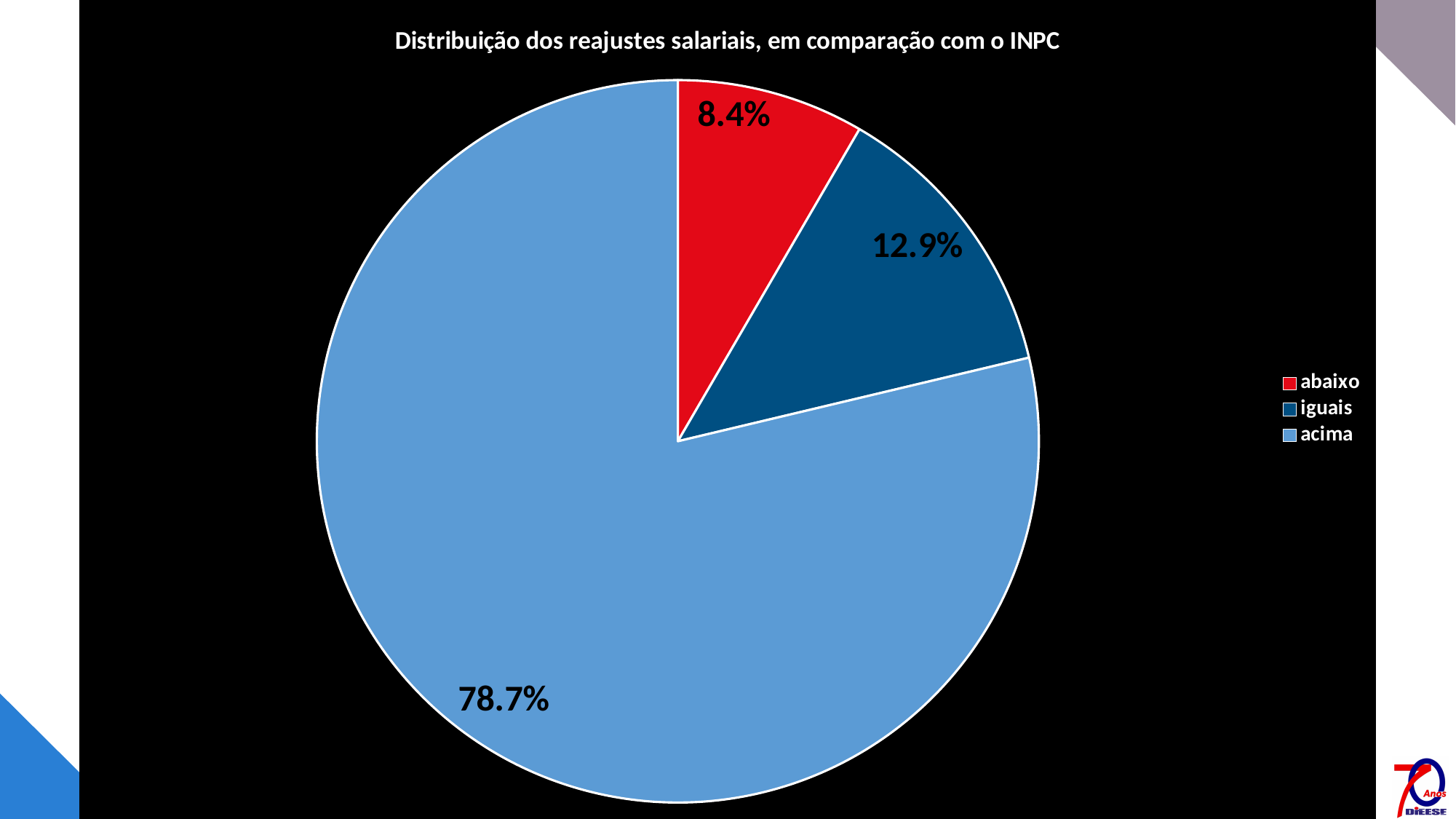
What is the difference between the 'iguais' and 'abaixo' shares? 4.5% What kind of chart is shown on the slide? pie chart Which is larger, the 'iguais' slice or the 'abaixo' slice? iguais What is the difference between the 'acima' and 'iguais' shares? 65.8% What colour is the 'abaixo' slice? red What is the title of the chart? Distribuição dos reajustes salariais, em comparação com o INPC How many slices does the pie chart have? 3 Which category has the smallest share of the pie? abaixo Which category has the largest share of the pie? acima What is the value for the 'abaixo' slice? 8.4% What is the value for the 'iguais' slice? 12.9% What is the value for the 'acima' slice? 78.7%